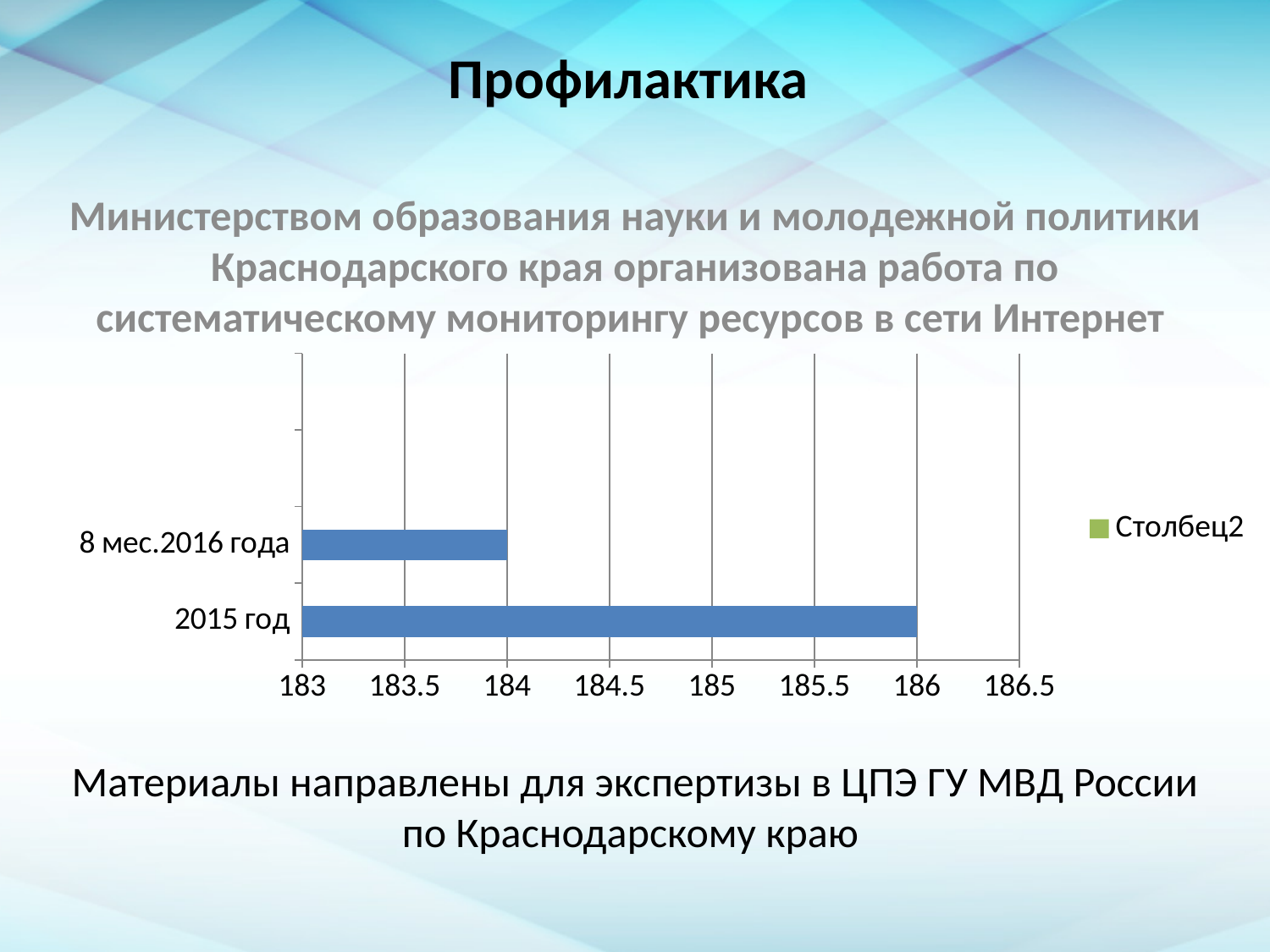
What is the value for 2015 год? 186 What is the name of the series shown in the legend? Столбец2 What is the difference between the values for 2015 год and 8 мес.2016 года? 2 Which is larger, the value for 2015 год or the value for 8 мес.2016 года? 2015 год What is the value for 8 мес.2016 года? 184 How many series does the legend list? 1 What kind of chart is shown on the slide? bar chart Which category has the lowest value? 8 мес.2016 года How many categories are plotted in the chart? 2 Is the value for 8 мес.2016 года greater or less than 185? less Which category has the highest value? 2015 год Is the value for 2015 год greater or less than 185? greater